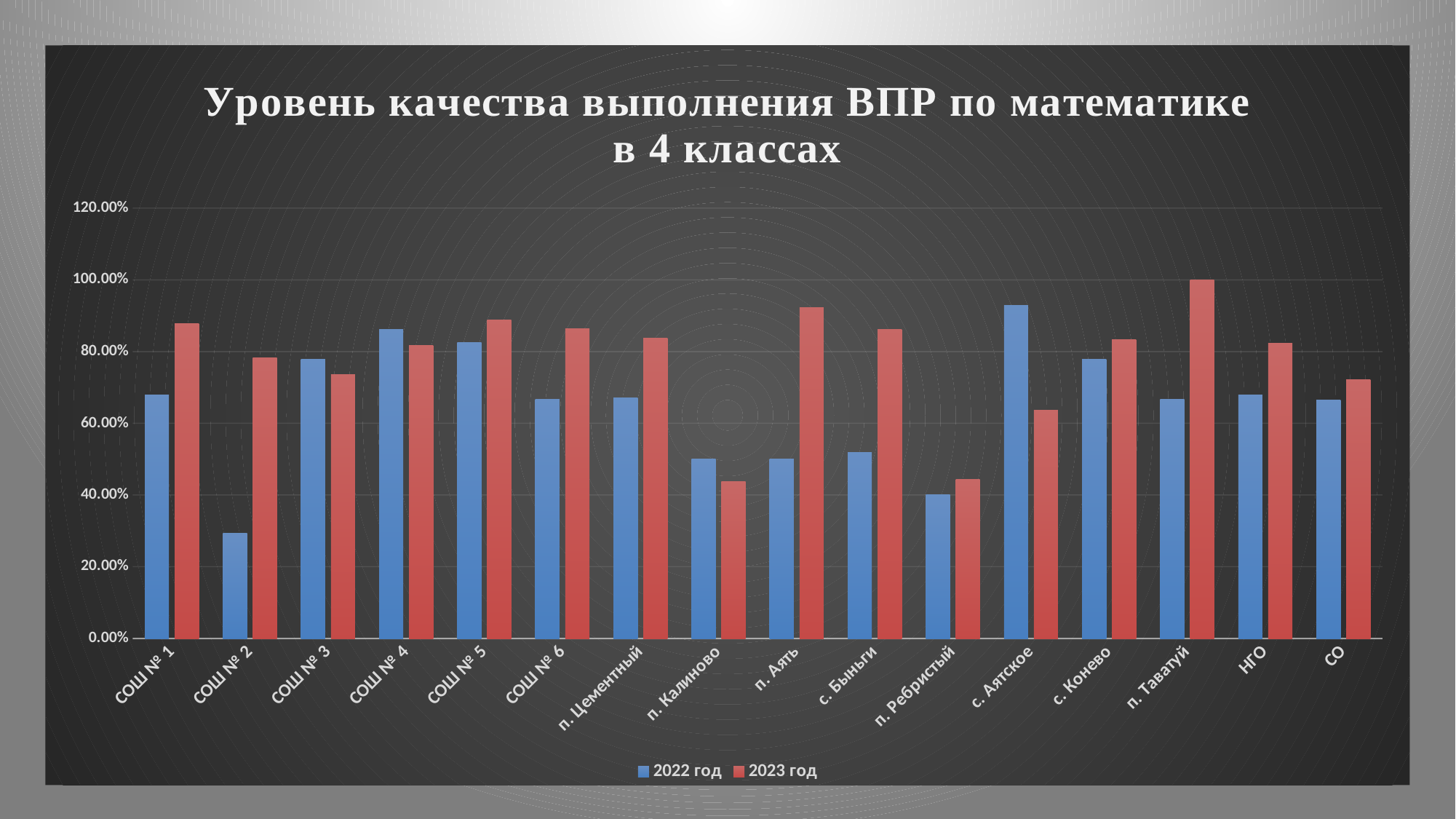
Is the value for п. Аять in the 2023 год series greater or less than 80.00%? greater How many categories (schools/settlements) are shown on the x axis? 16 Is the value for СОШ № 2 in the 2022 год series greater or less than 40.00%? less What are the two series listed in the legend? 2022 год and 2023 год What is the value for п. Таватуй in the 2023 год series? 100.00% How many series does the legend list? 2 For СОШ № 2, which series has the larger value, 2022 год or 2023 год? 2023 год Which category has the highest value in the 2023 год series? п. Таватуй What kind of chart is shown on the slide? bar chart Which category has the lowest value in the 2022 год series? СОШ № 2 For с. Аятское, which series has the larger value, 2022 год or 2023 год? 2022 год Which category has the highest value in the 2022 год series? с. Аятское